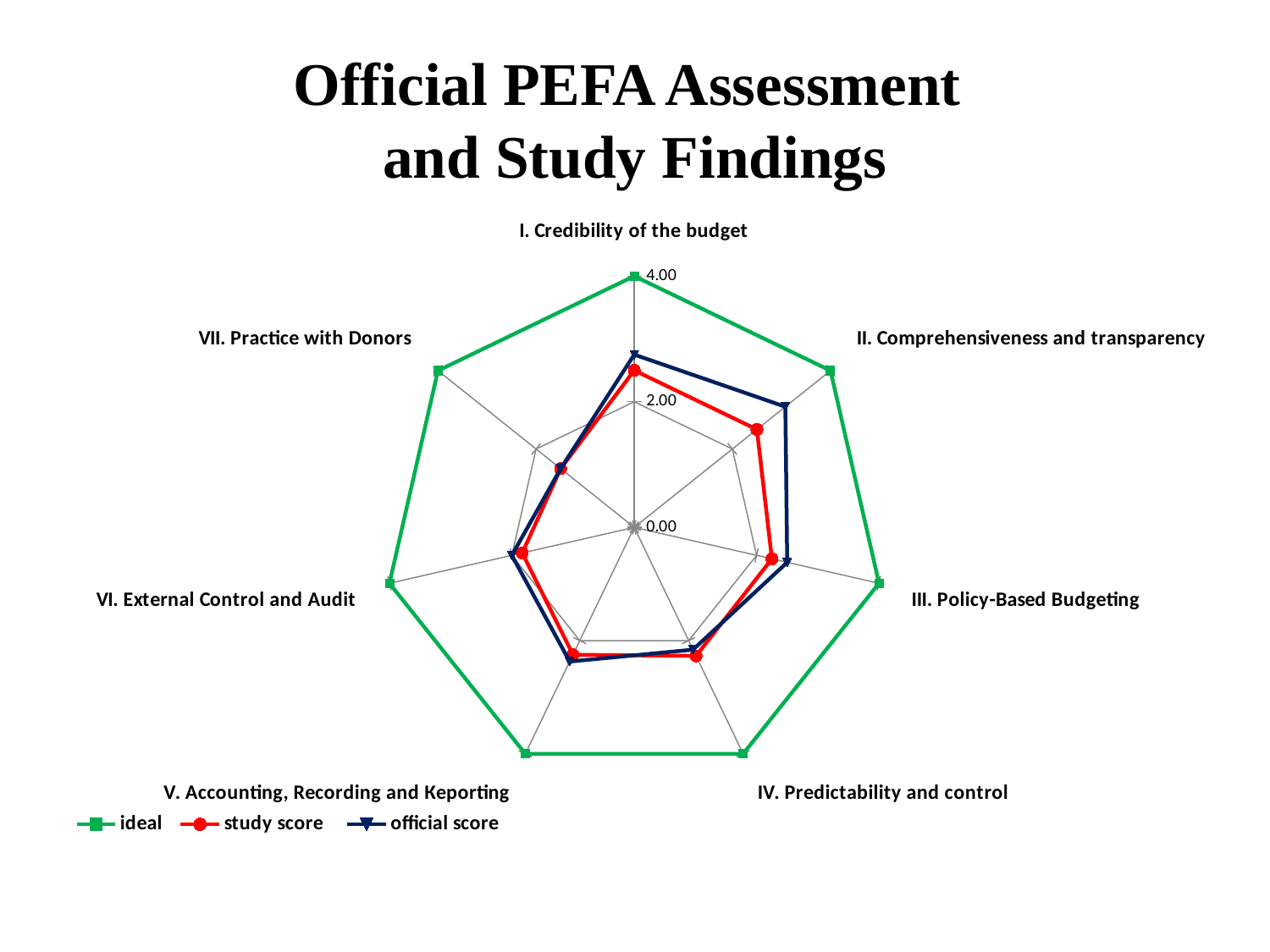
What kind of chart is shown on the slide? Radar chart Is the study score for I. Credibility of the budget greater or less than 2.00? greater What is the title of the slide? Official PEFA Assessment and Study Findings How many series does the legend list? 3 Is the study score for VII. Practice with Donors greater or less than 2.00? less How many categories (axes) does the radar chart have? 7 What is the value of the ideal series for IV. Predictability and control? 4.00 For II. Comprehensiveness and transparency, which is larger: the study score or the official score? official score Is the official score for II. Comprehensiveness and transparency greater or less than 2.00? greater For which category is the study score lowest? VII. Practice with Donors What is the value of the ideal series for I. Credibility of the budget? 4.00 Which colour is used for the study score series? Red